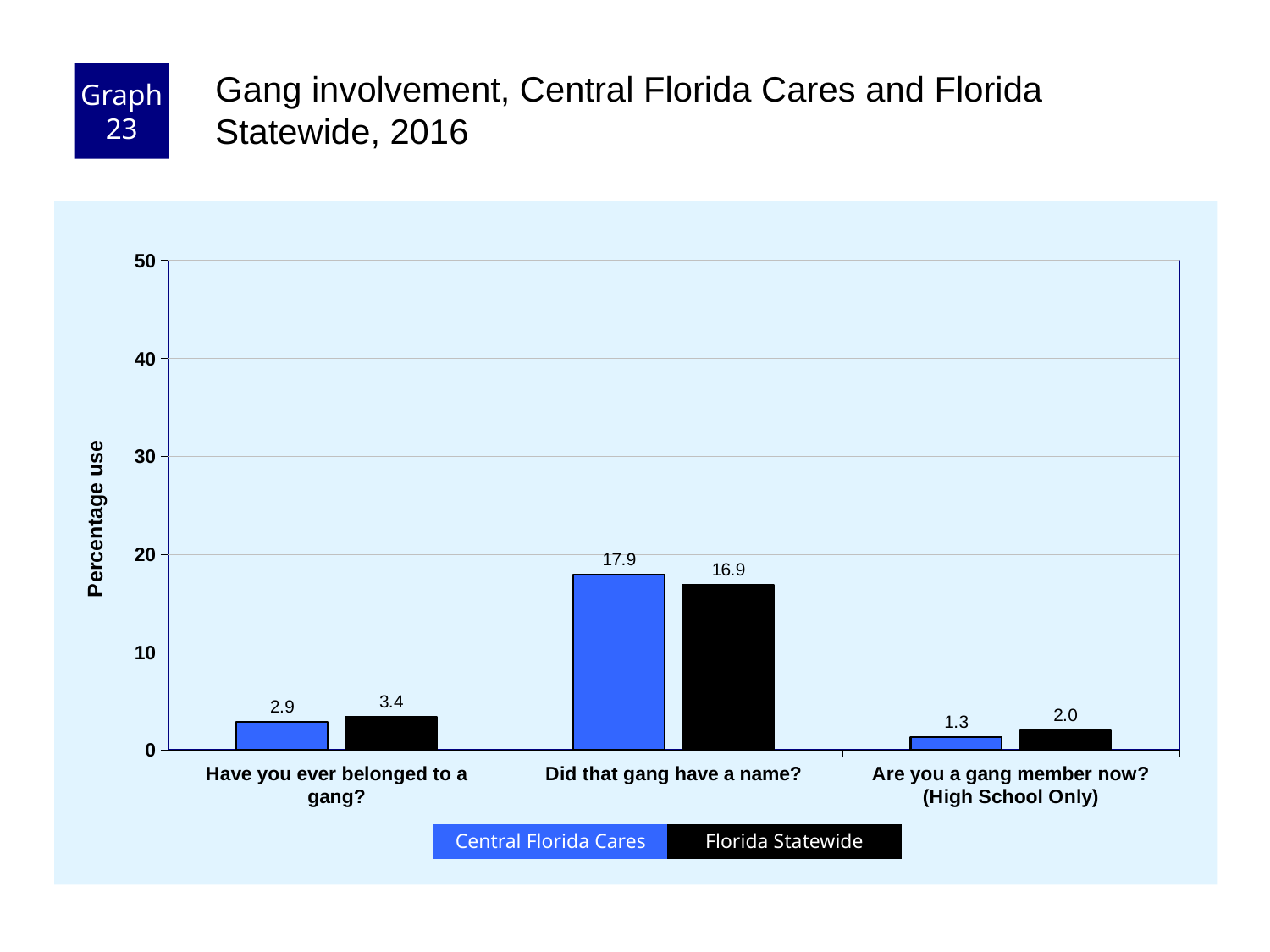
How many question categories are shown on the x axis? 3 What is the Florida Statewide value for "Have you ever belonged to a gang?"? 3.4 What kind of chart is shown? bar chart Which question has the lowest Florida Statewide value? Are you a gang member now? (High School Only) What is the Central Florida Cares value for "Are you a gang member now? (High School Only)"? 1.3 What is the Florida Statewide value for "Are you a gang member now? (High School Only)"? 2.0 What is the difference between the Central Florida Cares and Florida Statewide values for "Did that gang have a name?"? 1.0 How many series does the legend list? 2 For "Have you ever belonged to a gang?", which is larger: Central Florida Cares or Florida Statewide? Florida Statewide Is the Florida Statewide value for "Did that gang have a name?" greater or less than 20? less Which question has the highest Central Florida Cares value? Did that gang have a name? What is the Central Florida Cares value for "Did that gang have a name?"? 17.9